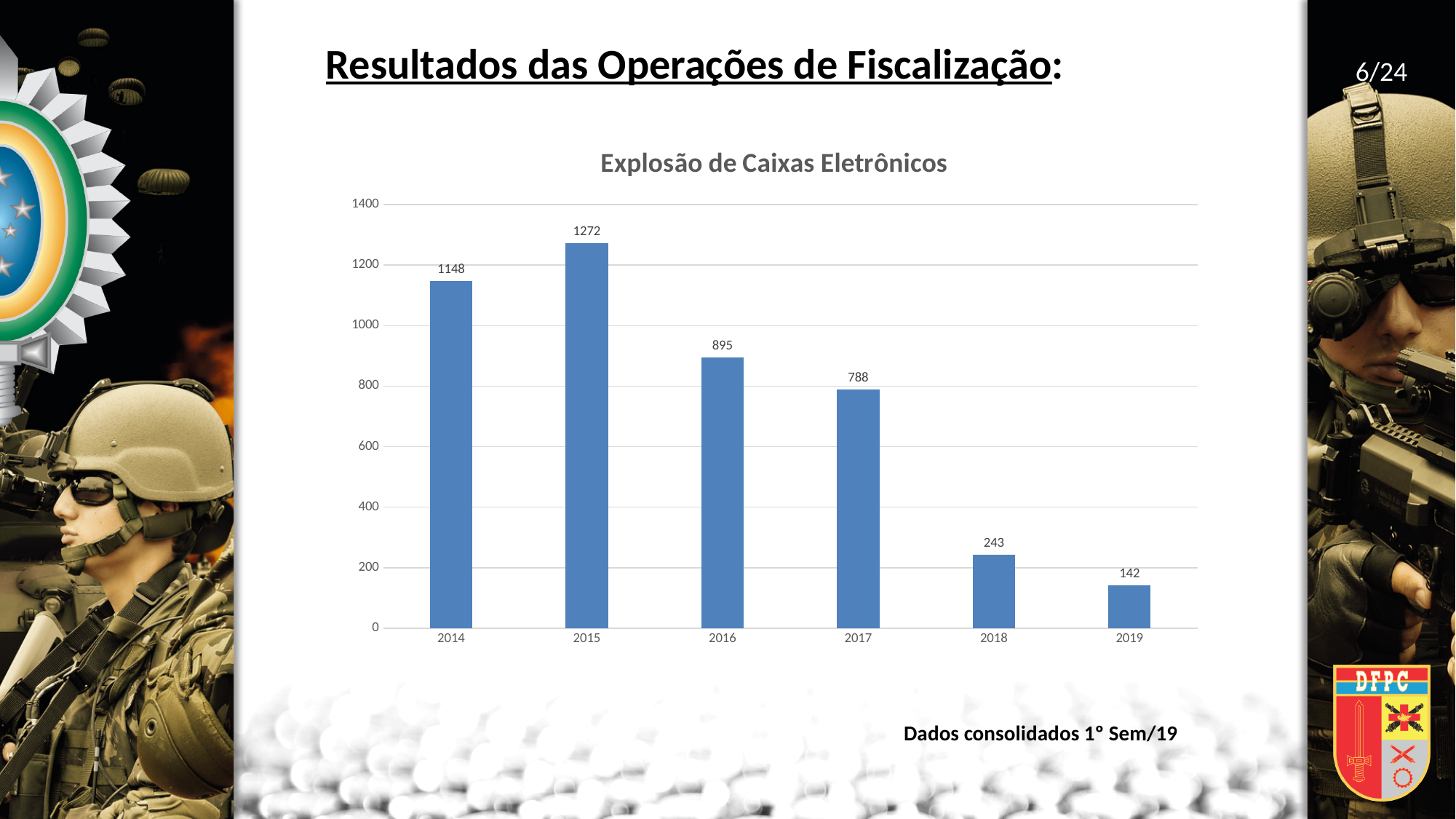
What is the value for 2014 in the chart? 1148 Which year has the lowest value? 2019 Which year has the highest value? 2015 What is the difference between the values for 2018 and 2019? 101 Do the values rise or fall from 2015 to 2019? Fall What is the value for 2017 in the chart? 788 What is the value for 2019 in the chart? 142 Which is larger, the value for 2016 or the value for 2017? 2016 What kind of chart is shown on the slide? Bar chart Is the value for 2016 greater or less than 800? greater How many years are shown on the x axis? 6 What is the difference between the values for 2015 and 2014? 124